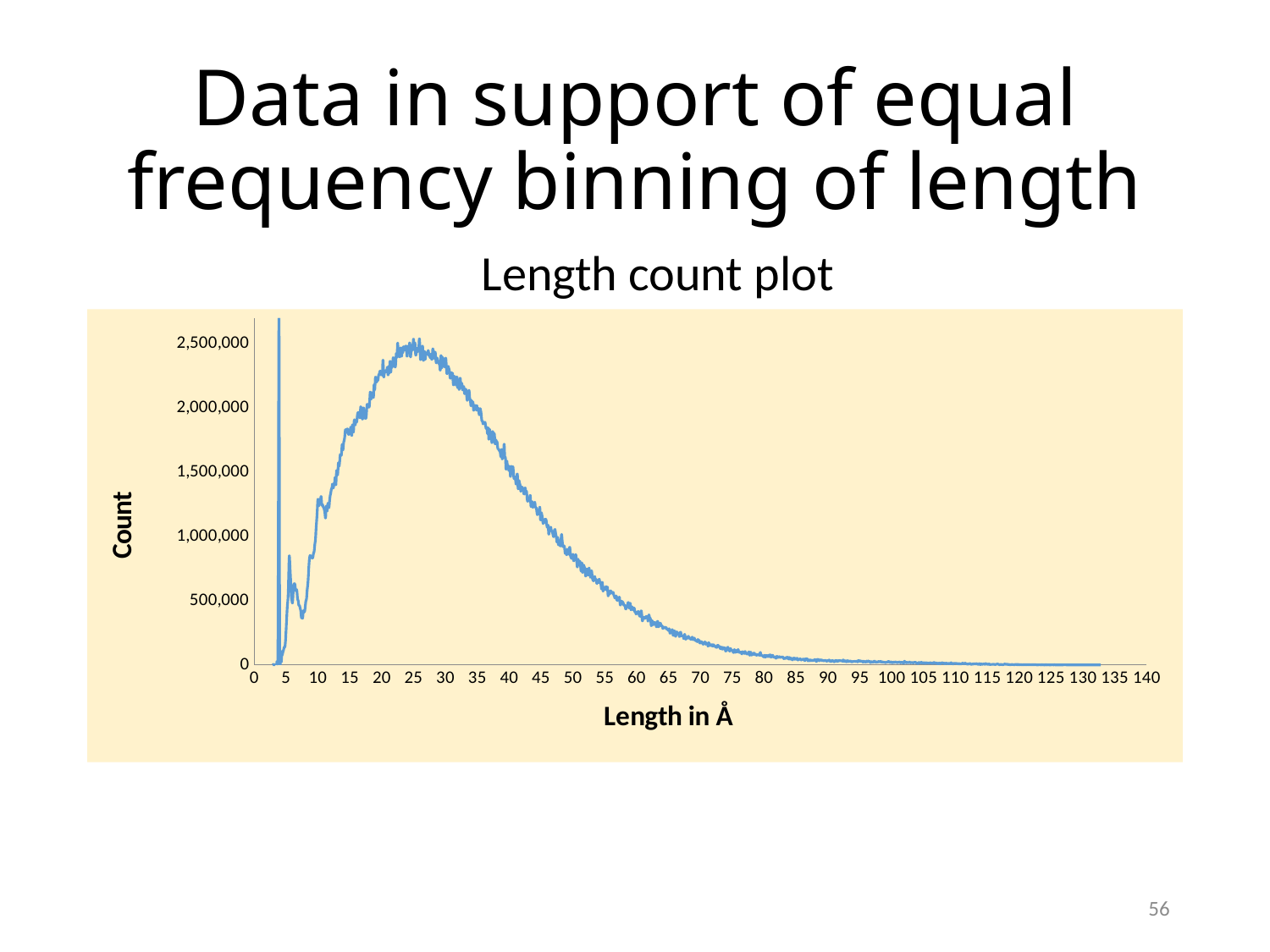
What is the title of the chart? Length count plot Is the count at a length of 55 Å greater or less than 1,000,000? less Does the count rise or fall as length increases from 10 Å to 25 Å? rise What kind of chart is shown on the slide? Line chart Is the count at a length of 15 Å greater or less than 1,500,000? greater Is the count at a length of 100 Å greater or less than 500,000? less Does the count rise or fall as length increases from 25 Å to 100 Å? fall What is the label of the x axis of the chart? Length in Å Which has the higher count, a length of 30 Å or a length of 70 Å? 30 Å